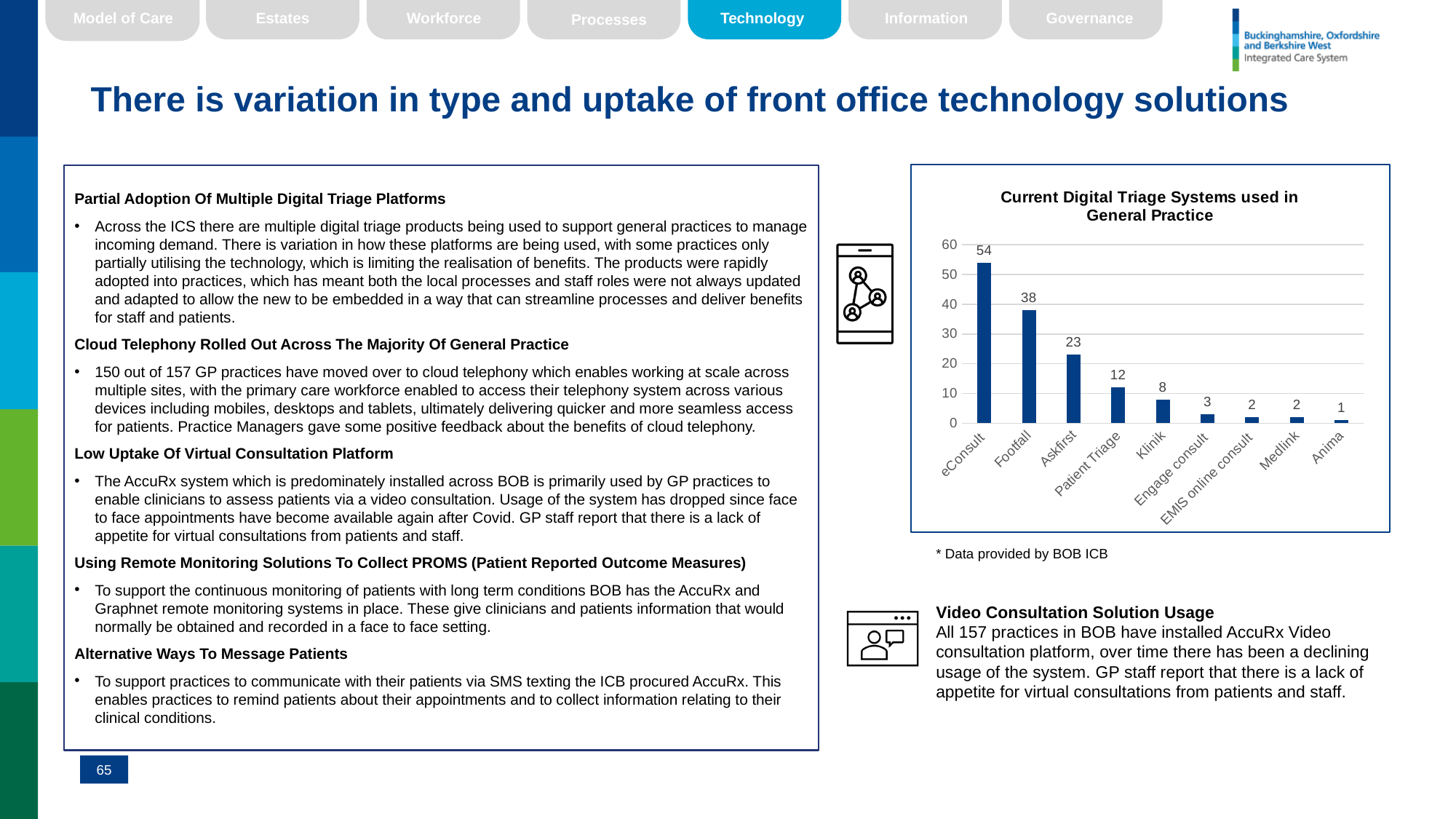
Which digital triage system has the lowest value in the chart? Anima Which has a larger value, Askfirst or Klinik? Askfirst What is the value for eConsult in the Current Digital Triage Systems chart? 54 Which digital triage system has the highest value in the chart? eConsult What is the value for Footfall in the chart? 38 What is the title of the chart on the slide? Current Digital Triage Systems used in General Practice What is the difference between the values for eConsult and Footfall? 16 How many digital triage systems are shown on the x axis of the chart? 9 What is the value for Patient Triage in the chart? 12 What kind of chart is used to show the Current Digital Triage Systems used in General Practice? Bar chart Do the values rise or fall moving from left to right along the x axis of the chart? Fall Is the value for Footfall greater or less than 30? greater